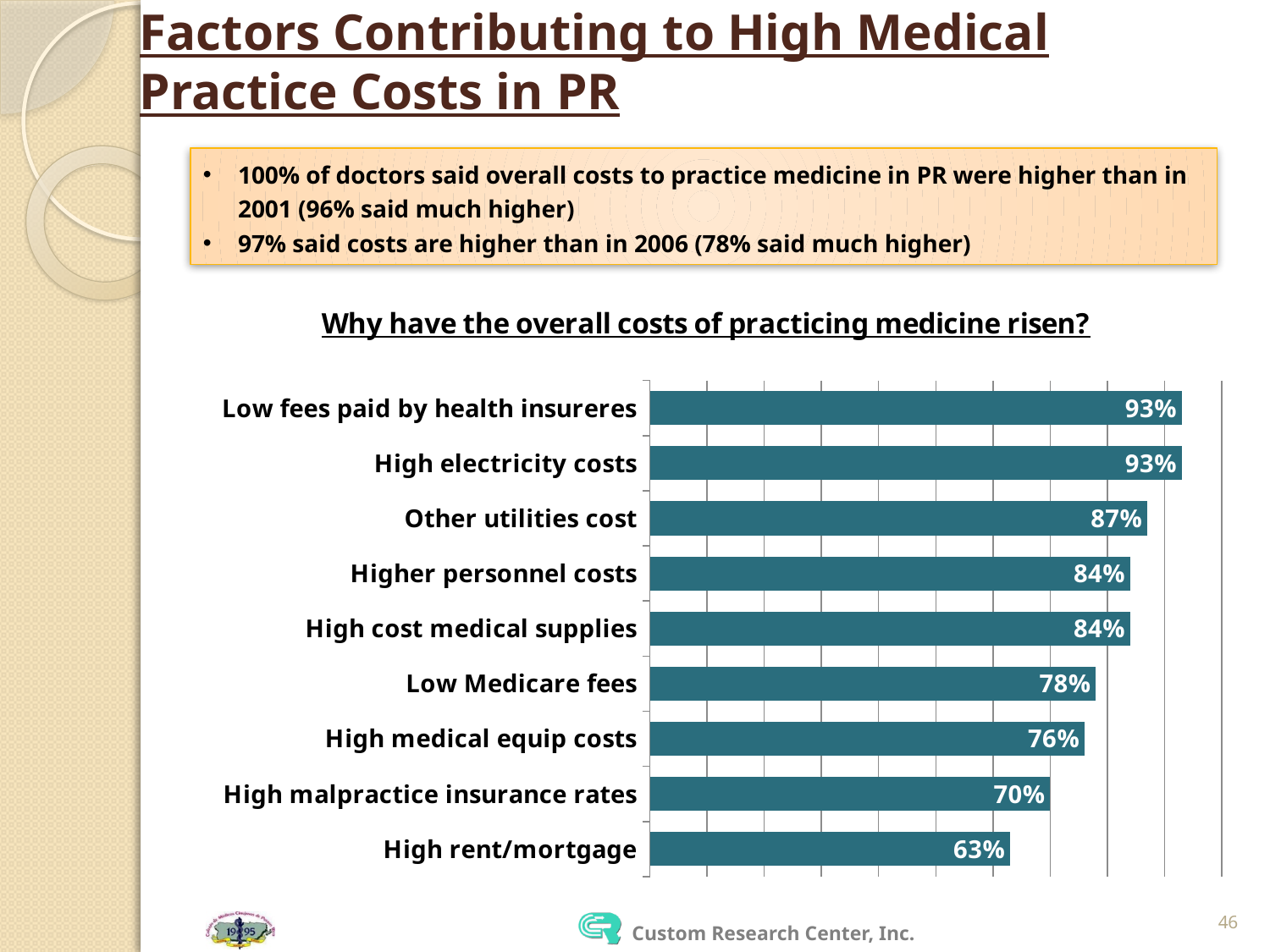
What is the difference between the values for Low Medicare fees and High medical equip costs? 2% What is the value shown for High malpractice insurance rates? 70% What question does the chart's heading ask? Why have the overall costs of practicing medicine risen? Which is larger, the value for High medical equip costs or the value for High malpractice insurance rates? High medical equip costs What is the value shown for Other utilities cost? 87% Which factor has the lowest percentage in the chart? High rent/mortgage What is the difference between the values for Other utilities cost and High rent/mortgage? 24% What percentage of doctors cited high electricity costs as a reason for rising costs? 93% What kind of chart is shown on the slide? Bar chart How many factors are listed in the chart? 9 Which is larger, the value for Higher personnel costs or the value for Low Medicare fees? Higher personnel costs What is the value shown for Low Medicare fees? 78%